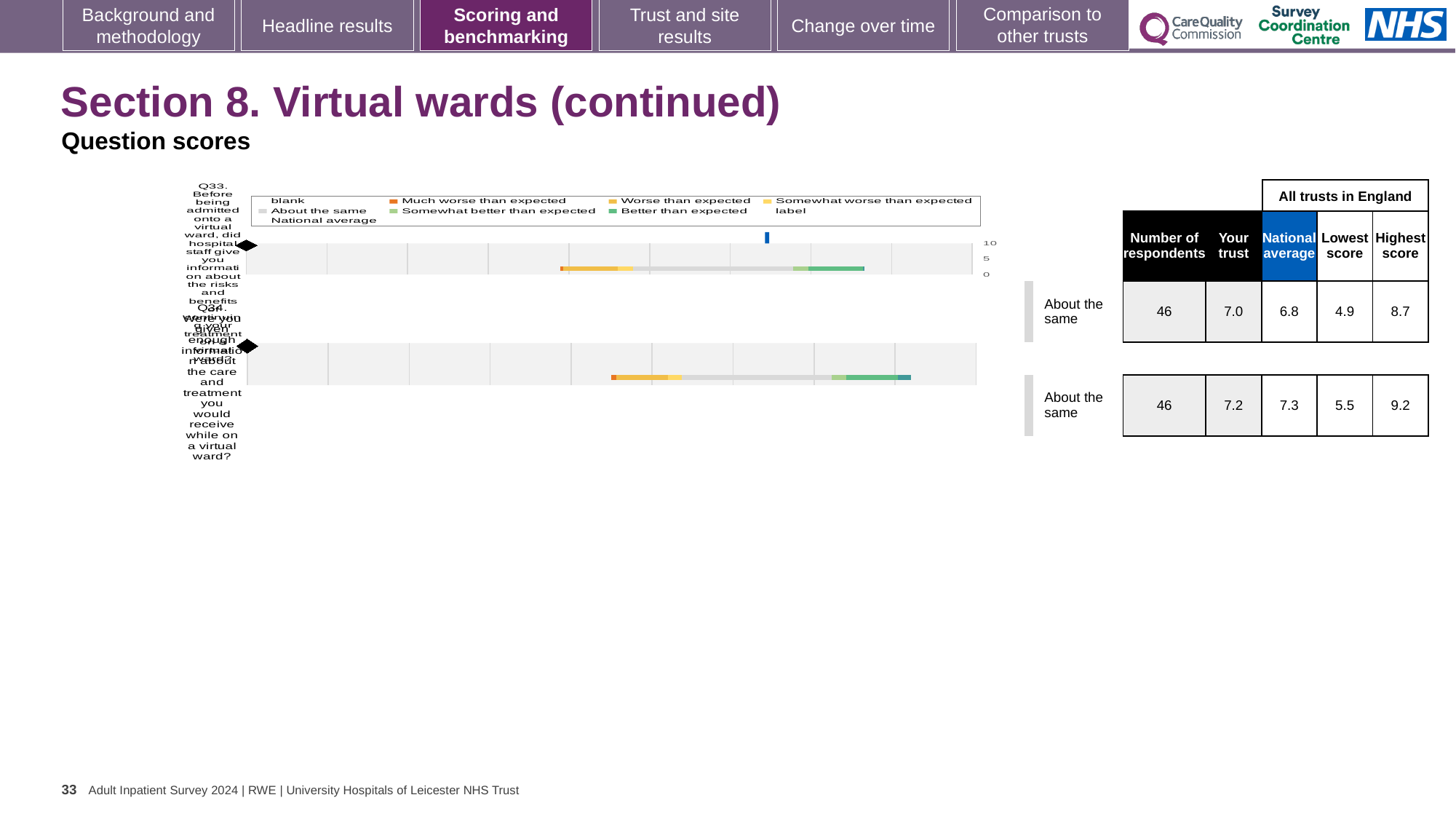
What is the difference between the highest and lowest scores for Q34? 3.7 What is the highest score among all trusts in England for Q33? 8.7 What benchmark category is shown for Q33? About the same How many respondents answered Q34? 46 What kind of chart is shown on the slide? Bar chart How many question bars are plotted in the chart? 2 What is the 'Your trust' score for Q33 in the table? 7.0 Which is larger for Q33: the 'Your trust' score or the national average? Your trust How many entries does the chart legend list? 9 What is the difference between the 'Your trust' scores for Q34 and Q33? 0.2 What is the lowest score among all trusts in England for Q34? 5.5 What is the national average score for Q34 in the table? 7.3